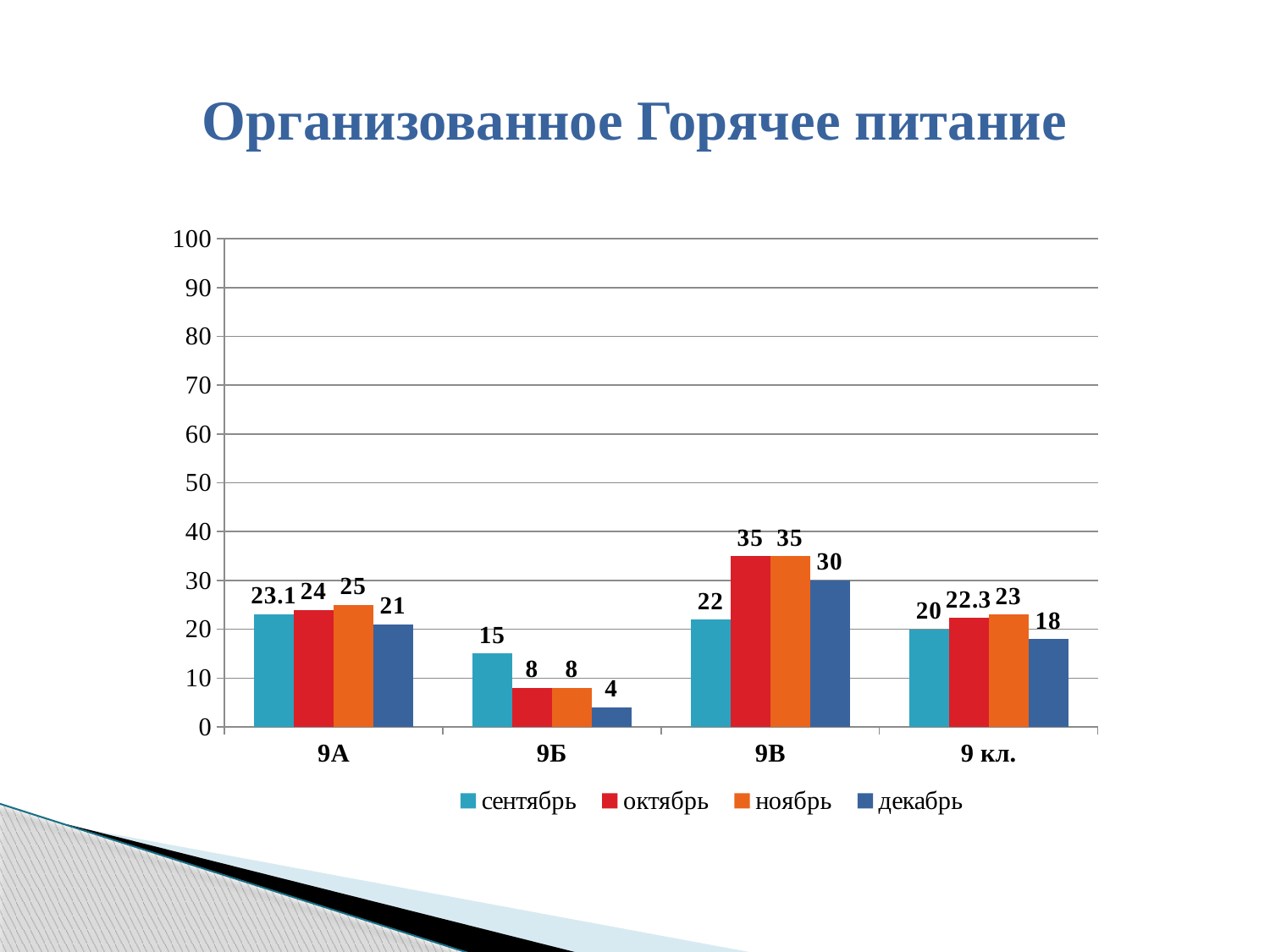
Which category has the highest value in ноябрь? 9В What kind of chart is shown on the slide? bar chart How many series does the legend list? 4 What is the difference between the октябрь values for 9В and 9Б? 27 Is the value for 9В in октябрь greater or less than 30? greater What is the title of the slide? Организованное Горячее питание Which category has the lowest value in декабрь? 9Б How many categories are shown on the x axis? 4 What is the value for 9 кл. in октябрь? 22.3 What is the value for 9Б in сентябрь? 15 Which is larger: the сентябрь value for 9А or the сентябрь value for 9В? 9А What is the value for 9В in декабрь? 30